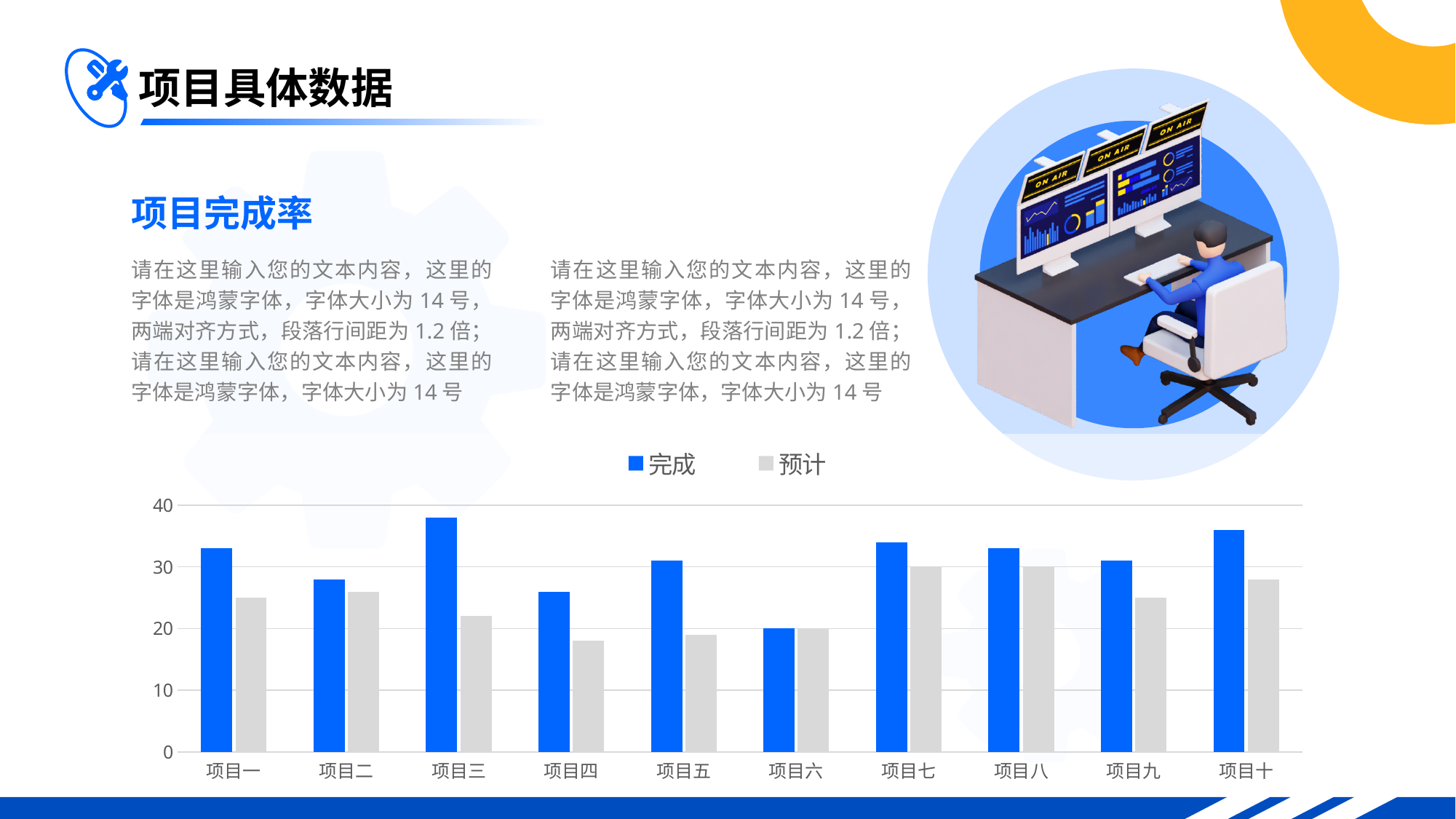
Which category has the lowest 完成 value? 项目六 Is the 完成 value for 项目十 greater or less than 30? greater How many categories (项目) are shown on the x axis of the chart? 10 Is the 完成 value for 项目三 greater or less than 30? greater What are the two series names shown in the chart legend? 完成 and 预计 How many series does the chart legend list? 2 For 项目一, which is larger: the 完成 value or the 预计 value? 完成 Which category has the highest 完成 value? 项目三 Is the 预计 value for 项目四 greater or less than 20? less What is the 完成 value for 项目六? 20 What kind of chart is shown on the slide? bar chart What is the 预计 value for 项目七? 30